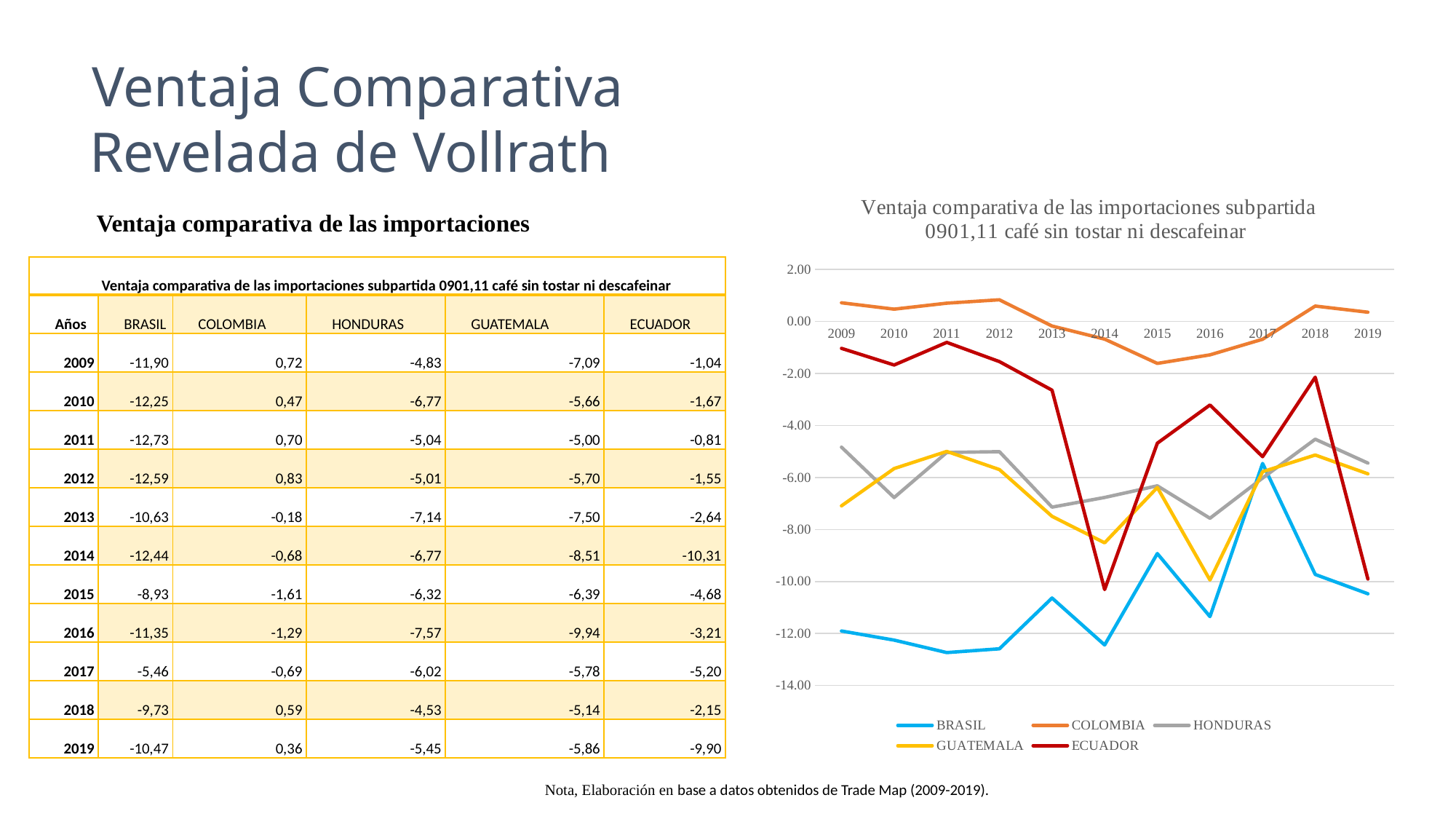
What colour is the COLOMBIA line in the chart? orange How many years are plotted along the x axis of the chart? 11 Does the BRASIL line rise or fall from 2009 to 2011? fall Which country has the highest value in 2012? COLOMBIA What is the value for ECUADOR in 2014? -10,31 What kind of chart is shown on the slide? line chart Is the value for BRASIL in 2011 greater or less than -12.00? less What is the difference between the BRASIL value in 2017 and in 2016? 5,89 What is the value for BRASIL in 2009? -11,90 Which country has the lowest value in 2016? BRASIL In 2018, which is higher: ECUADOR or HONDURAS? ECUADOR How many series does the chart legend list? 5